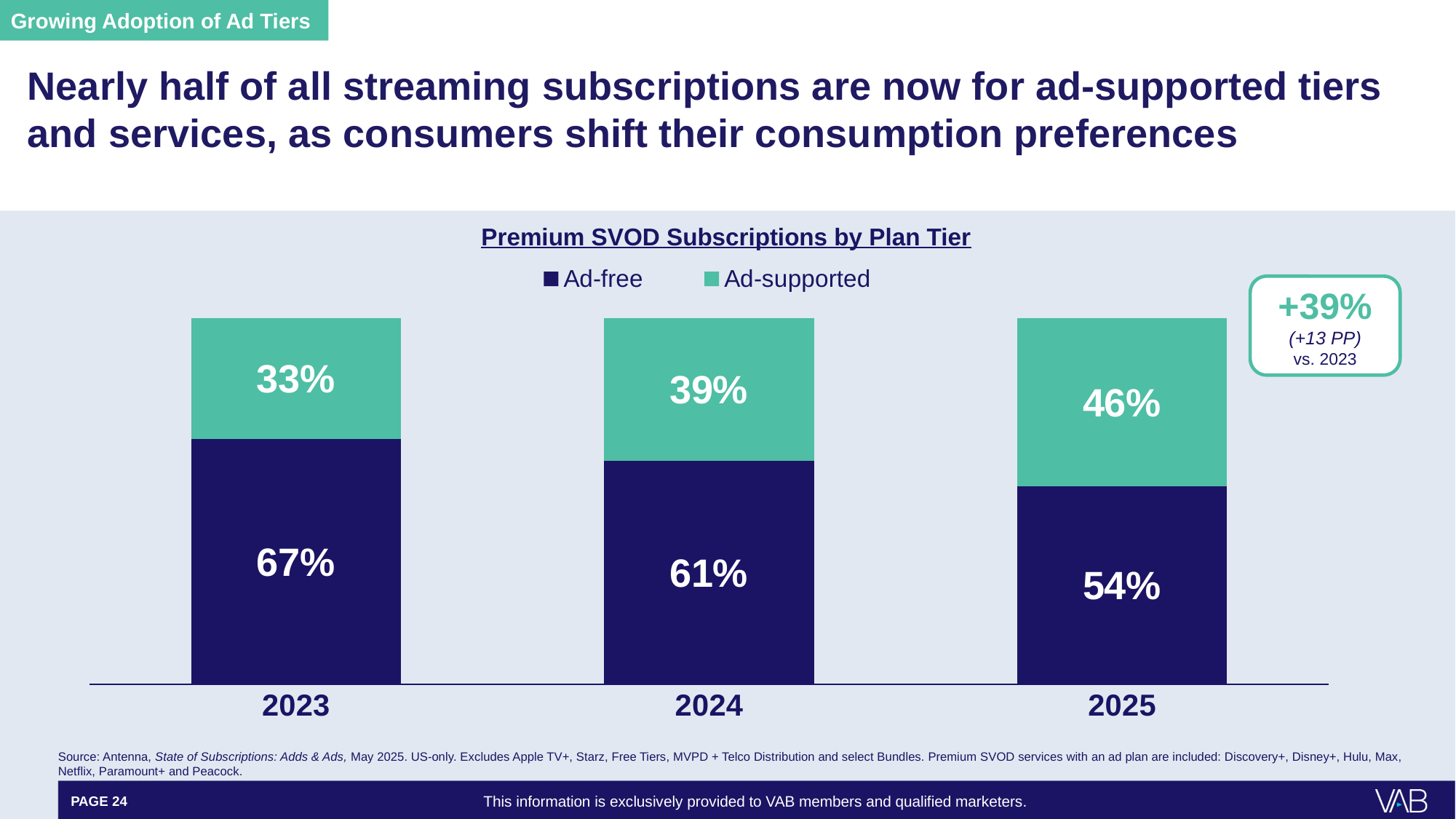
In which year is the Ad-supported share highest? 2025 What is the Ad-supported value for 2024? 39% How many years are shown on the x axis of the chart? 3 By how many percentage points did the Ad-supported share change from 2023 to 2025? 13 Which is larger in 2024, the Ad-free share or the Ad-supported share? Ad-free Does the Ad-free share rise or fall from 2023 to 2025? Fall In which year is the Ad-free share lowest? 2025 How many series does the legend list? 2 What is the Ad-free share of Premium SVOD subscriptions in 2025? 54% What is the title of the chart? Premium SVOD Subscriptions by Plan Tier What is the Ad-supported share of Premium SVOD subscriptions in 2023? 33% What kind of chart is shown on the slide? Stacked bar chart